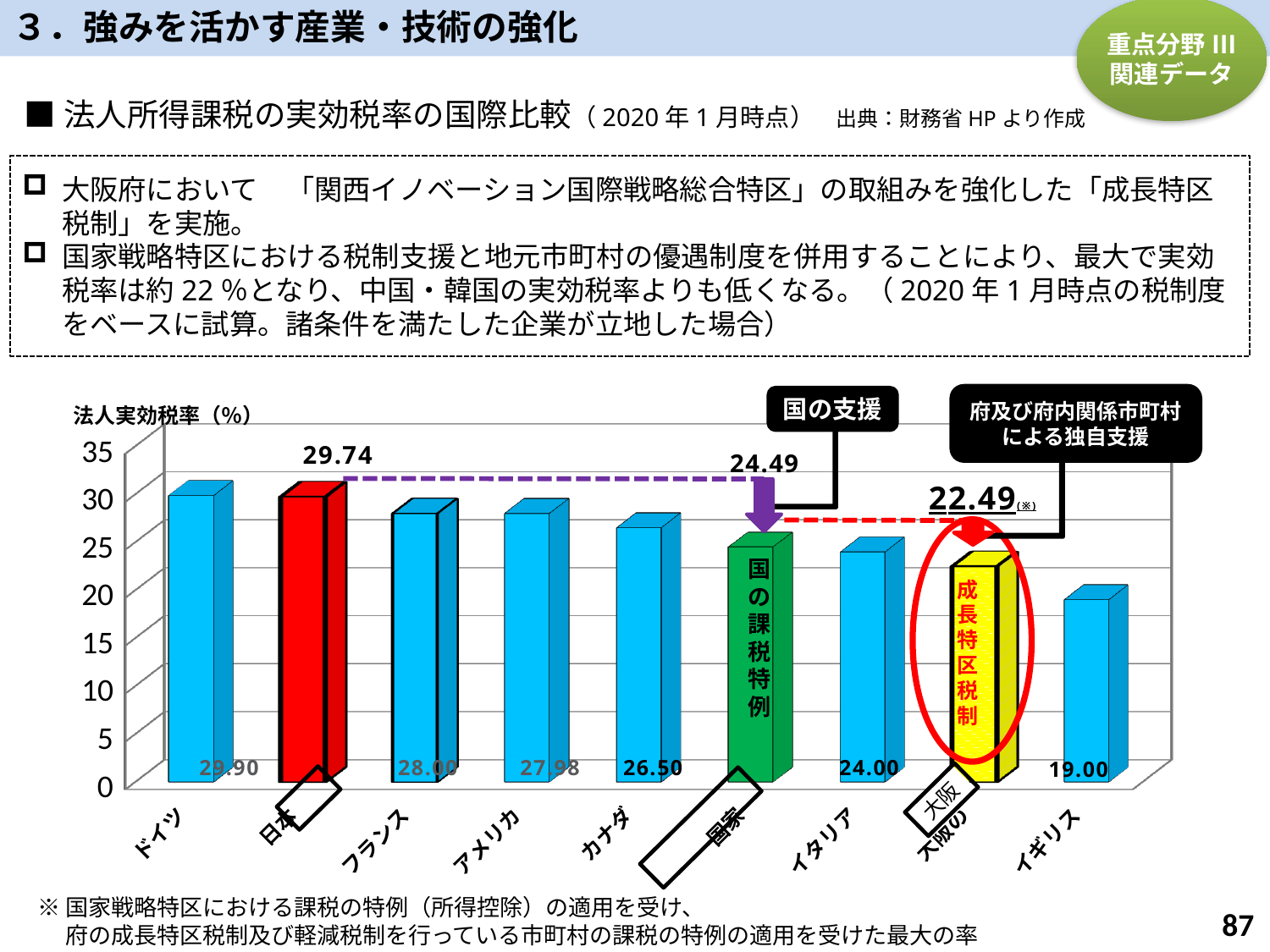
What colour is the bar for 日本? Red What kind of chart is shown on the slide? Bar chart Which is larger, the value for イタリア or the value for カナダ? カナダ How many bars are plotted in the chart? 9 What is the value shown for the yellow bar labelled 成長特区税制 (Osaka)? 22.49 What is the value for カナダ (Canada) in the chart? 26.50 Which category has the lowest value in the chart? イギリス What is the difference between the values for 日本 and イギリス? 10.74 What is the value for イギリス (UK) in the chart? 19.00 What is the value for 日本 (Japan) in the chart? 29.74 What is the label of the vertical axis of the chart? 法人実効税率（%） Do the values generally rise or fall from left to right along the x axis? Fall